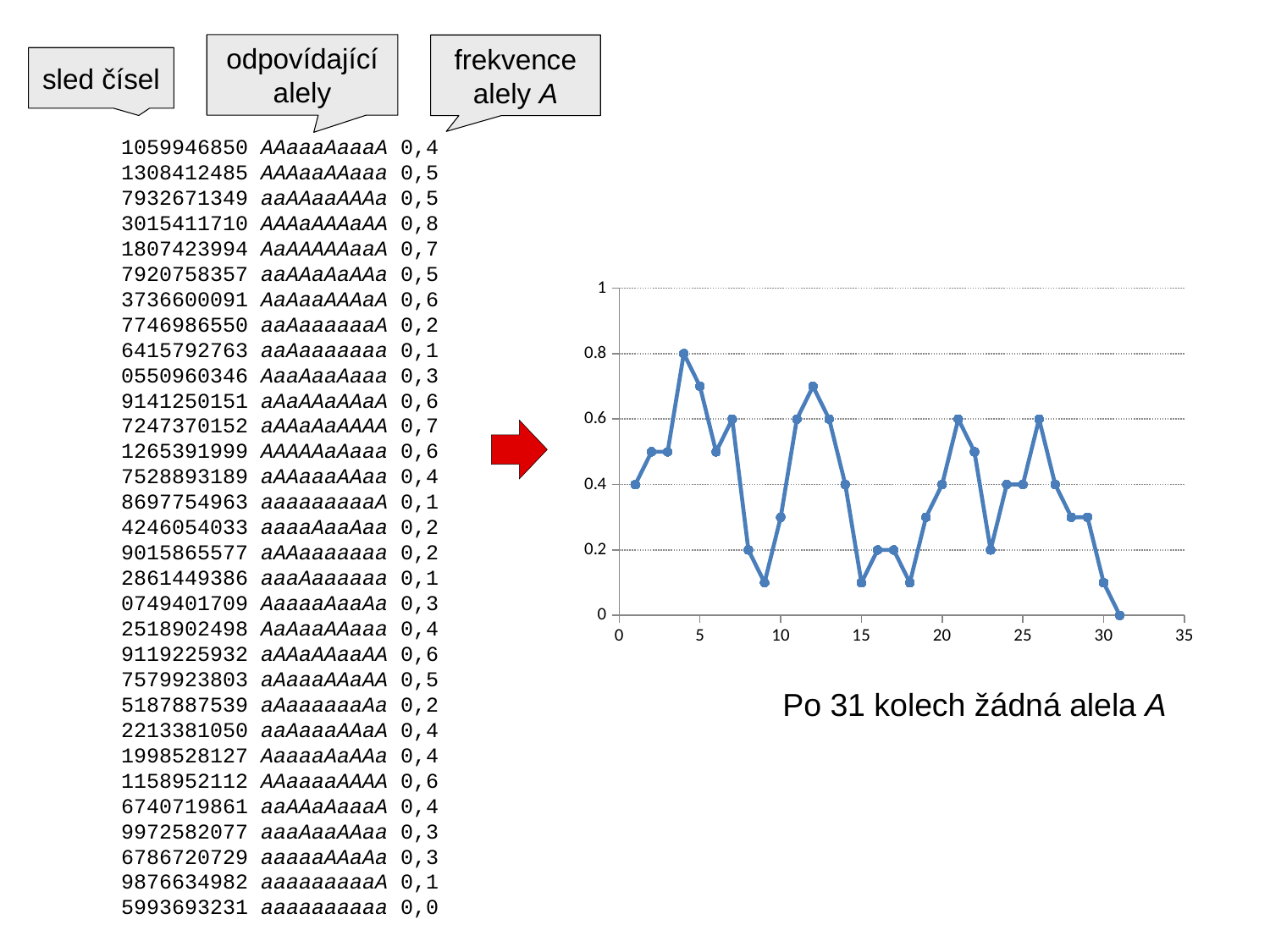
At which x value does the line chart reach its lowest point? 31 What is the value of the last point (x = 31) on the line chart? 0 Is the value at x = 12 on the line chart greater or less than 0.6? greater What is the maximum value shown on the y axis of the line chart? 1 What is the value of the first point (x = 1) on the line chart? 0.4 Overall, do the values on the line chart rise or fall from the first point to the last point? fall How many data points are plotted on the line chart? 31 Which is larger on the line chart: the value at x = 4 or the value at x = 21? x = 4 What kind of chart is shown on the slide? line chart At which x value does the line chart reach its highest point? 4 Is the value at x = 9 on the line chart greater or less than 0.2? less What is the highest value reached on the line chart? 0.8